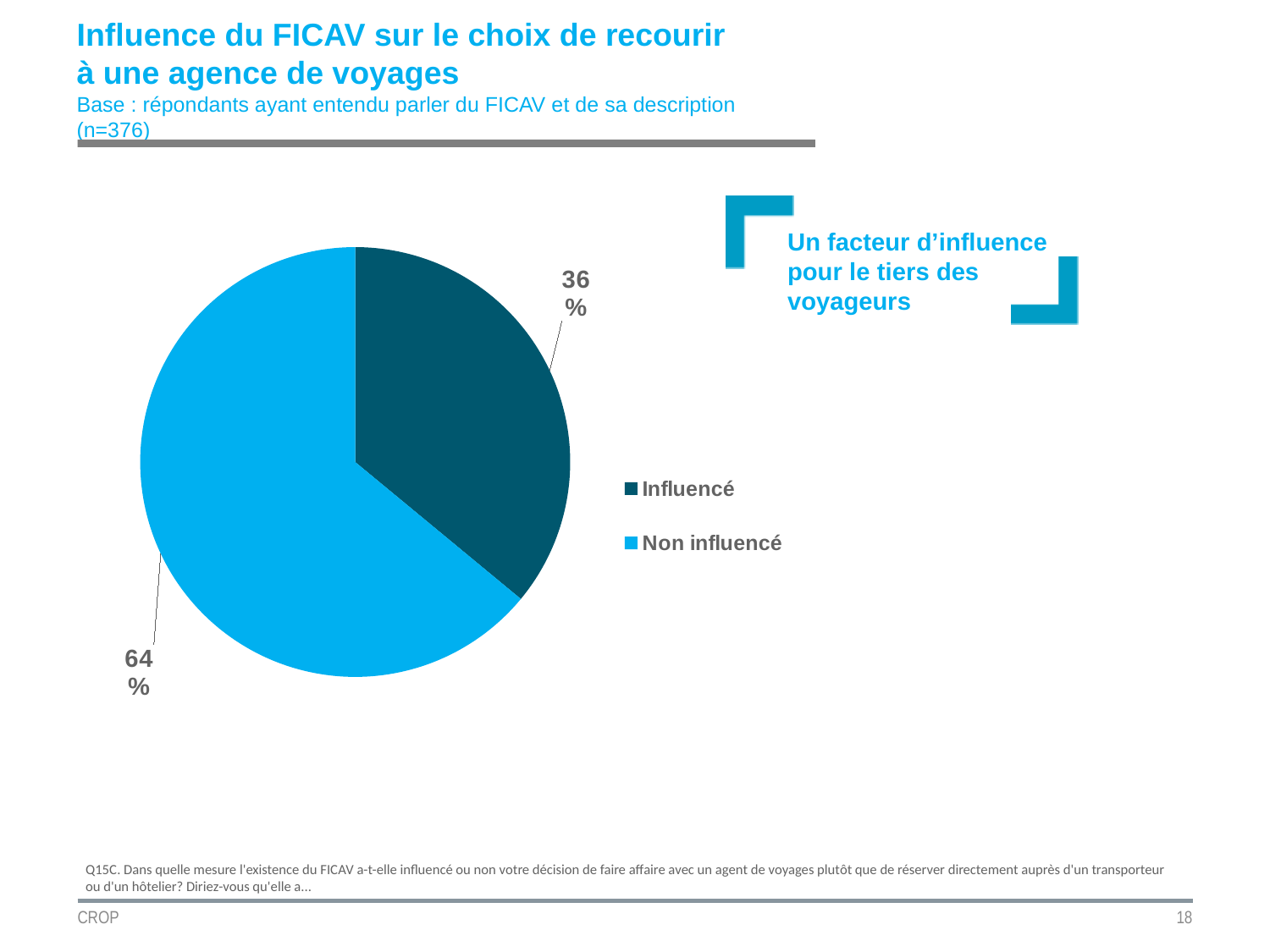
What percentage of respondents were 'Non influencé'? 64% What percentage of respondents were 'Influencé'? 36% What share of the pie does the 'Influencé' slice represent? 36% What is the difference in percentage points between 'Non influencé' and 'Influencé'? 28 Which is larger, the share for 'Influencé' or for 'Non influencé'? Non influencé What is the base size (n) stated for the chart? n=376 What kind of chart is shown on the slide? Pie chart Which legend entry is shown in the darker blue colour? Influencé Which category has the largest share of the pie? Non influencé How many categories does the pie chart show? 2 Which category has the smallest share of the pie? Influencé